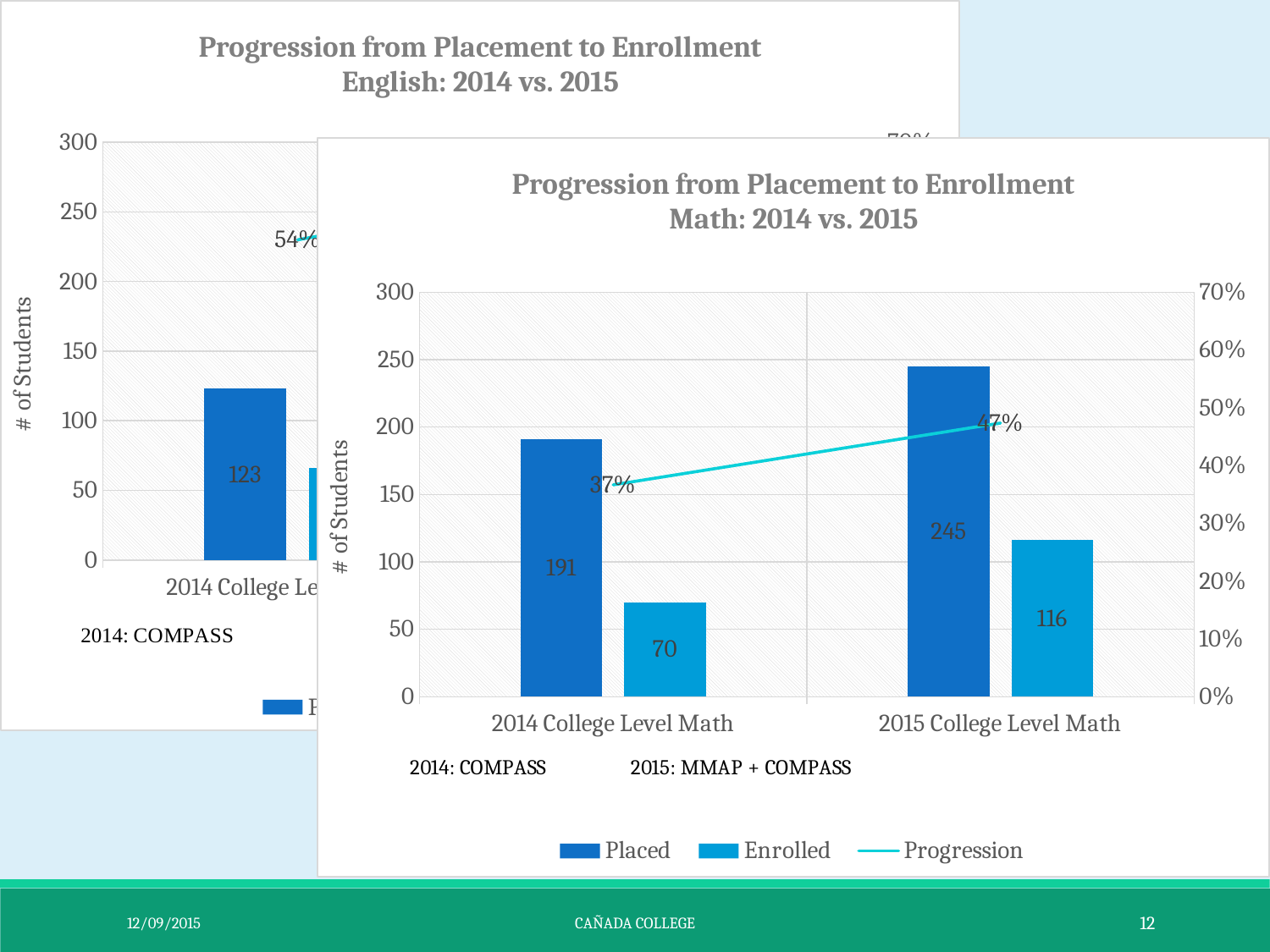
What kind of chart is the Math chart? bar chart with a line In the Math chart, what is the difference between the number Placed and the number Enrolled in 2015 College Level Math? 129 In the Math chart, how many more students were Placed in 2015 College Level Math than in 2014 College Level Math? 54 In the Math chart, what is the Progression percentage for 2014 College Level Math? 37% In the Math chart, does the Progression line rise or fall from 2014 to 2015? rise In the Math chart, how many students were Enrolled in 2015 College Level Math? 116 In the Math chart, what is the Progression percentage for 2015 College Level Math? 47% In the English chart, how many students were Placed in 2014 College Level English? 123 How many series does the legend of the Math chart list? 3 In the Math chart, which category has the highest Placed value? 2015 College Level Math In the Math chart, how many students were Placed in 2014 College Level Math? 191 In the Math chart, which is larger: Enrolled in 2014 College Level Math or Enrolled in 2015 College Level Math? Enrolled in 2015 College Level Math